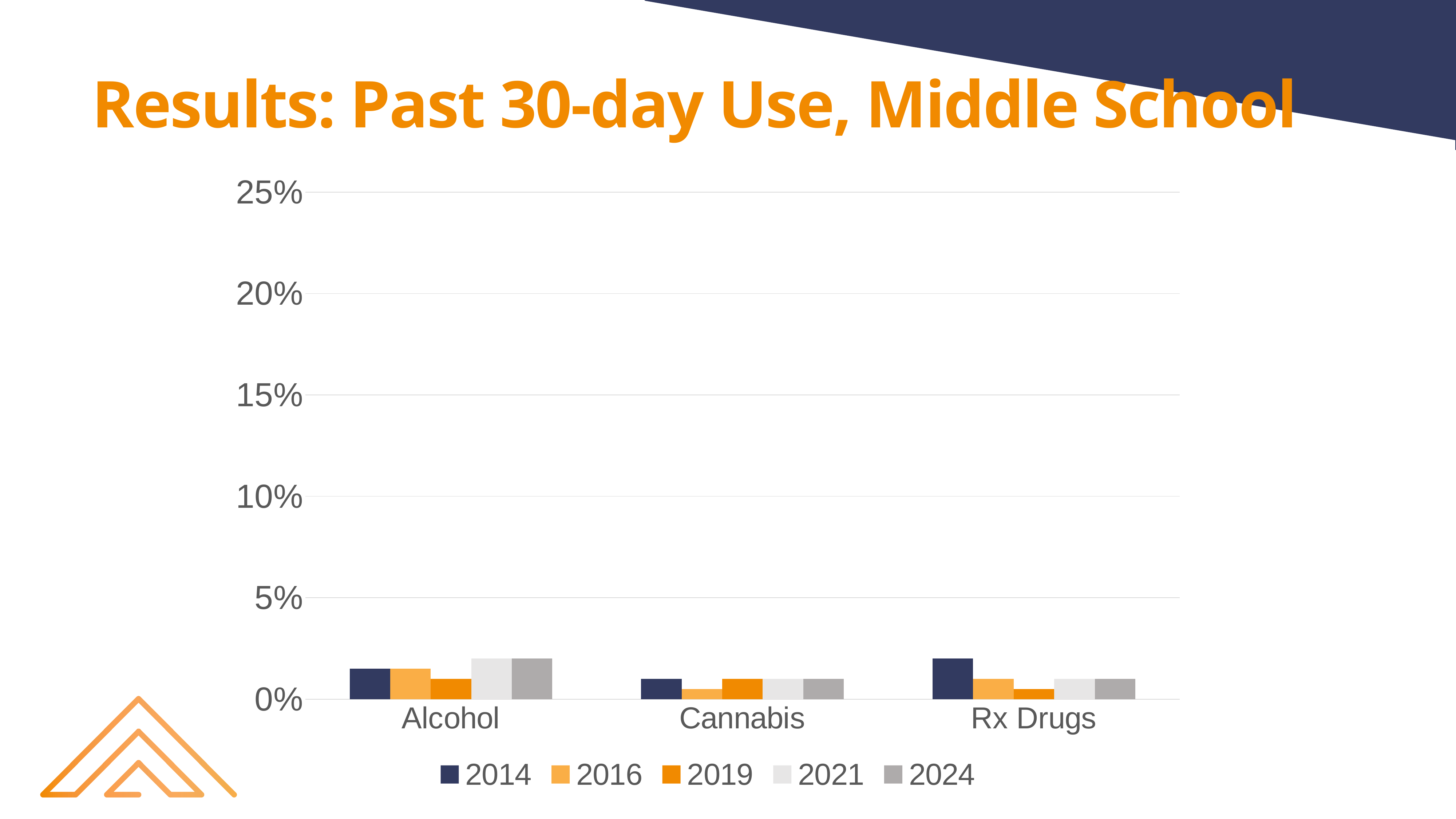
Within the Cannabis category, which year has the lowest value? 2016 Is the value for Cannabis in 2019 greater or less than 10%? less How many series does the chart's legend list? 5 What kind of chart is shown on the slide? bar chart What is the title of the slide containing the chart? Results: Past 30-day Use, Middle School Is the value for Alcohol in 2024 greater or less than 5%? less Which is larger: the 2024 value for Alcohol or the 2024 value for Cannabis? Alcohol Which is larger: the 2014 value for Rx Drugs or the 2019 value for Rx Drugs? 2014 How many categories are shown on the x axis of the chart? 3 Is the value for Rx Drugs in 2014 greater or less than 5%? less Which years are listed in the chart's legend? 2014, 2016, 2019, 2021, 2024 Within the Rx Drugs category, which year has the highest value? 2014